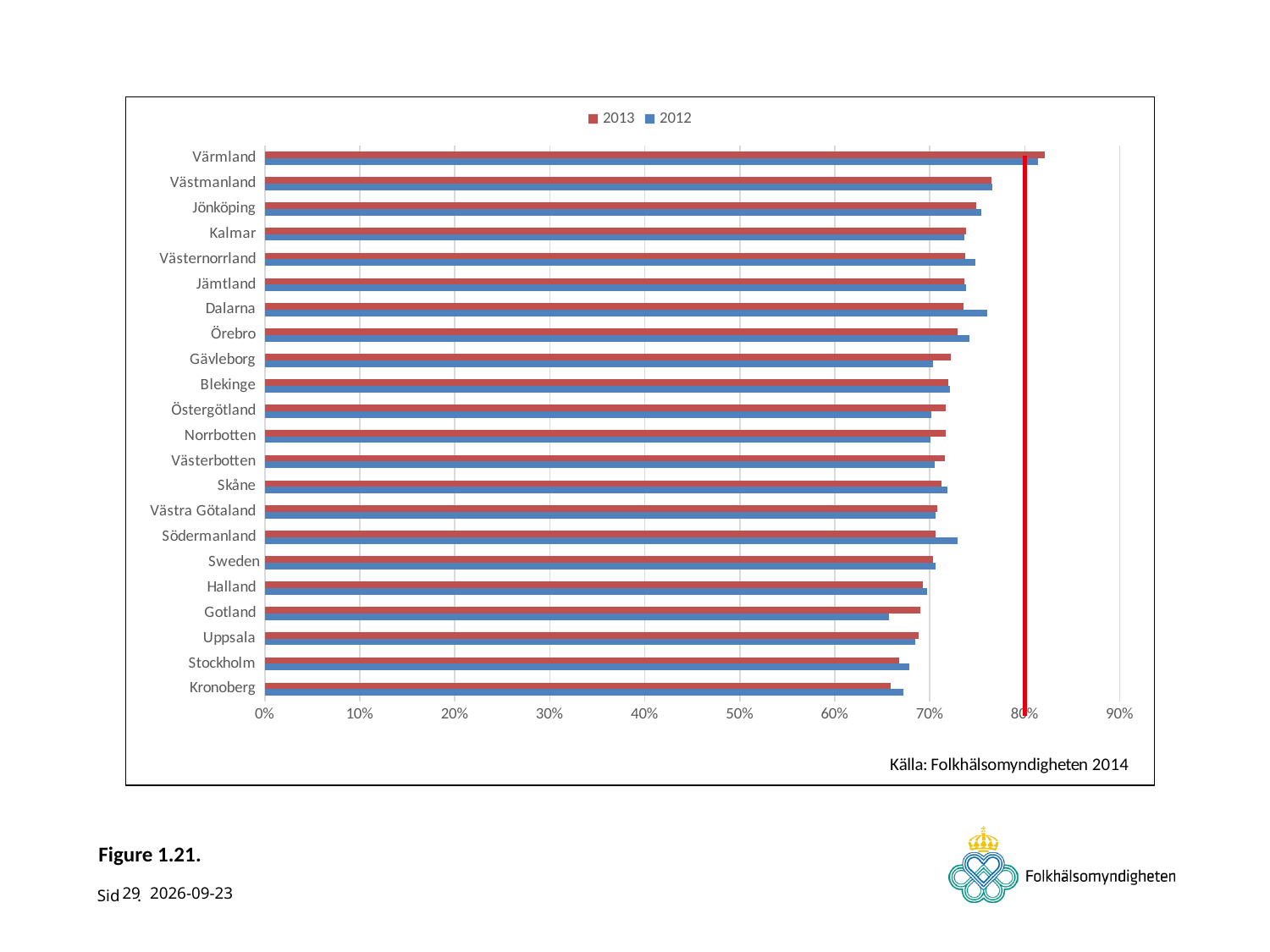
Is the 2012 value for Gotland greater or less than 70%? less Which category has the highest value for 2013? Värmland What source is cited at the bottom of the chart? Källa: Folkhälsomyndigheten 2014 How many series does the legend list? 2 Which series is shown in red in the legend? 2013 Is the 2013 value for Kronoberg greater or less than 70%? less Is the 2013 value for Värmland greater or less than 80%? greater Which category has the lowest value for 2013? Kronoberg How many categories are plotted on the vertical axis? 22 Which is larger, the 2013 value for Värmland or the 2013 value for Stockholm? Värmland What kind of chart is shown on the slide? Bar chart